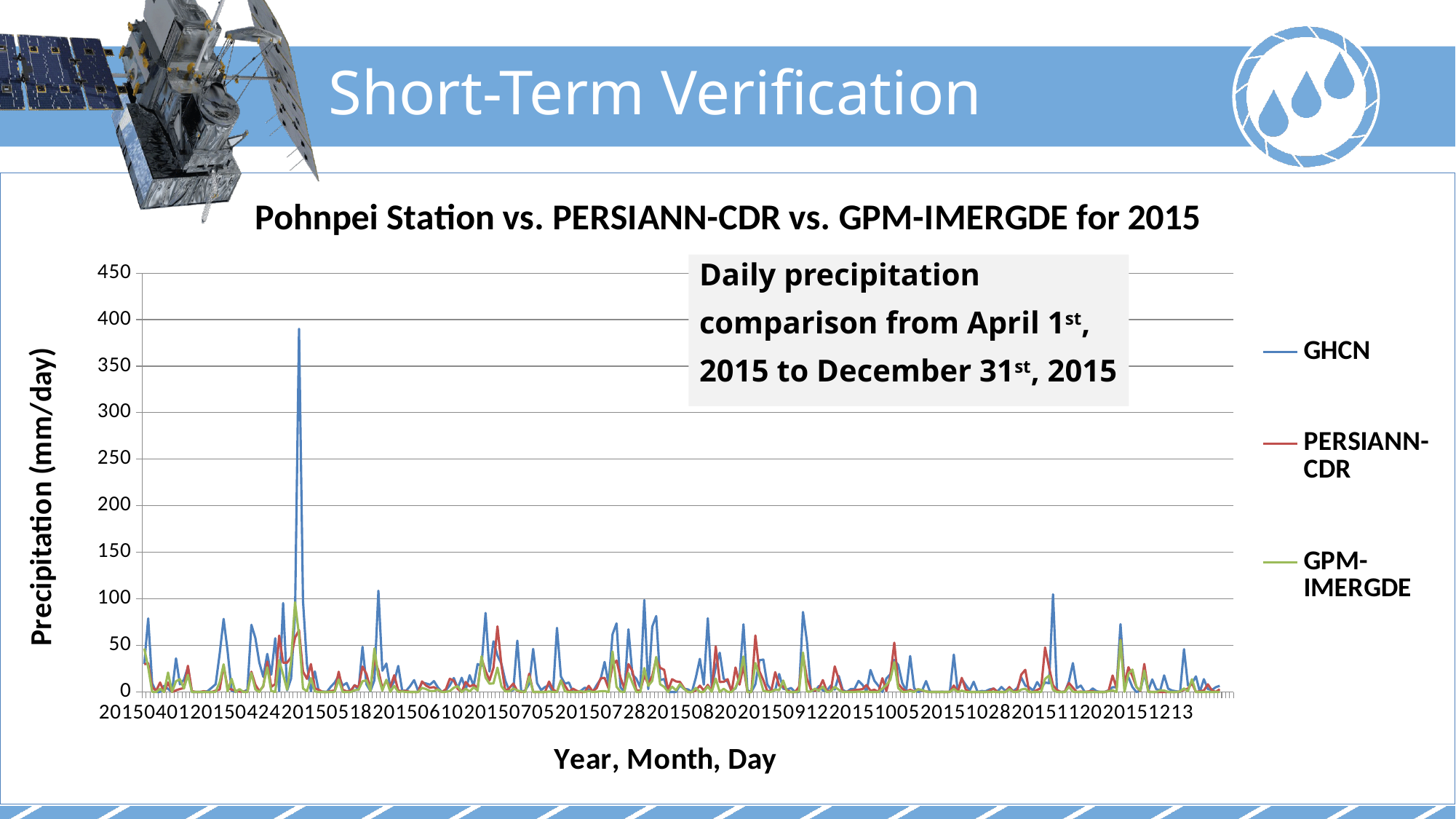
What kind of chart is shown on the slide? line chart Which series has the larger maximum value, GHCN or GPM-IMERGDE? GHCN Is the highest peak of the GHCN series greater or less than 350? greater Is the highest peak of the PERSIANN-CDR series greater or less than 100? less Which series reaches the highest peak value in the chart? GHCN What is the title of the chart? Pohnpei Station vs. PERSIANN-CDR vs. GPM-IMERGDE for 2015 What is the maximum value shown on the y axis? 450 Is the highest peak of the GHCN series greater or less than 400? less How many series does the legend list? 3 What is the label of the y axis? Precipitation (mm/day)